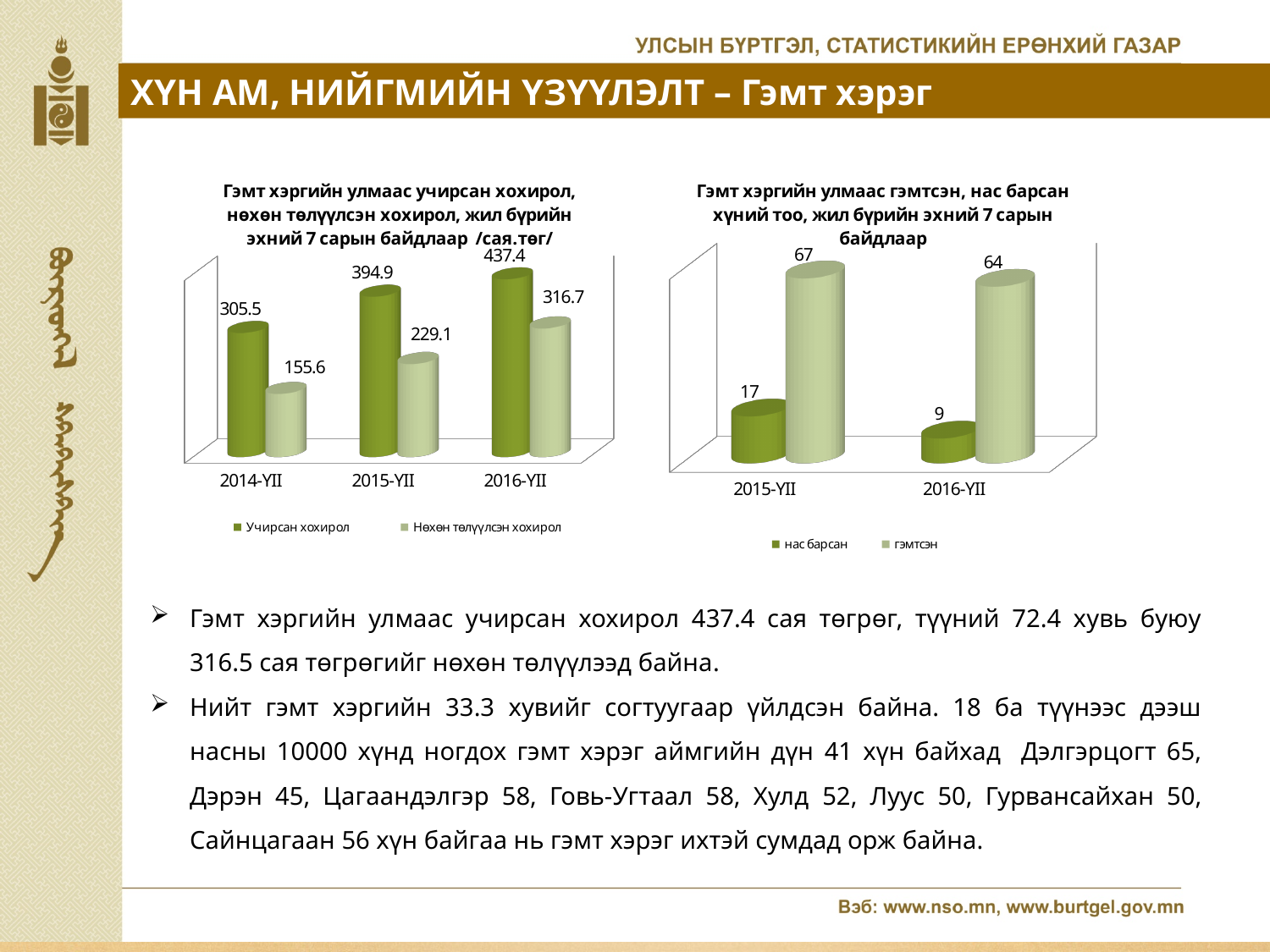
In the left chart, what is the difference between Учирсан хохирол and Нөхөн төлүүлсэн хохирол for 2015-YII? 165.8 In the left chart, does Учирсан хохирол rise or fall from 2014-YII to 2016-YII? rise What type of chart is the right chart? bar chart In the left chart, what is the value of Нөхөн төлүүлсэн хохирол for 2014-YII? 155.6 How many series does the legend of the left chart list? 2 In the left chart, what is the value of Учирсан хохирол for 2016-YII? 437.4 In the right chart, which is larger: нас барсан for 2015-YII or нас барсан for 2016-YII? 2015-YII In the right chart, what is the value of нас барсан for 2016-YII? 9 In the right chart, what is the value of гэмтсэн for 2015-YII? 67 In the left chart, which year has the highest Учирсан хохирол value? 2016-YII In the left chart, which year has the lowest Нөхөн төлүүлсэн хохирол value? 2014-YII In the right chart, what is the difference between гэмтсэн and нас барсан for 2016-YII? 55